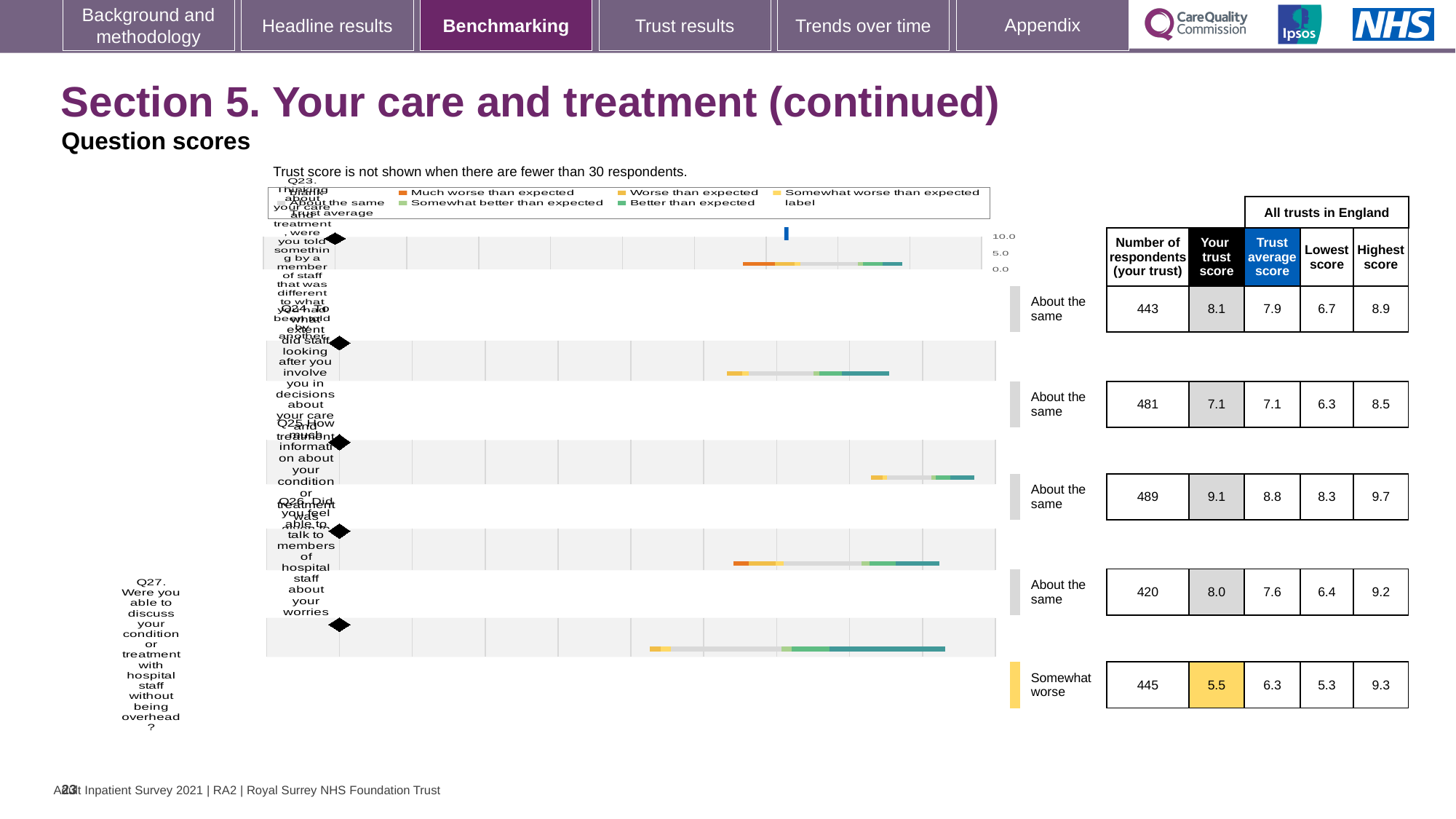
What is the trust average score for Q23? 7.9 Which question has the highest trust score? Q25 Which question has the lowest trust score? Q27 What is the lowest score across all trusts in England for Q24? 6.3 What is the highest score across all trusts in England for Q25? 9.7 For Q26, which is larger: the trust score or the trust average score? the trust score (8.0) How many questions (Q23 to Q27) are plotted in the chart? 5 What kind of chart is used to show the question scores on this slide? bar chart What is the trust score for Q27 (able to discuss your condition or treatment without being overheard)? 5.5 What is the difference between the trust average score and the trust score for Q27? 0.8 How many respondents answered Q25 at this trust? 489 What benchmark category is shown for Q27? Somewhat worse